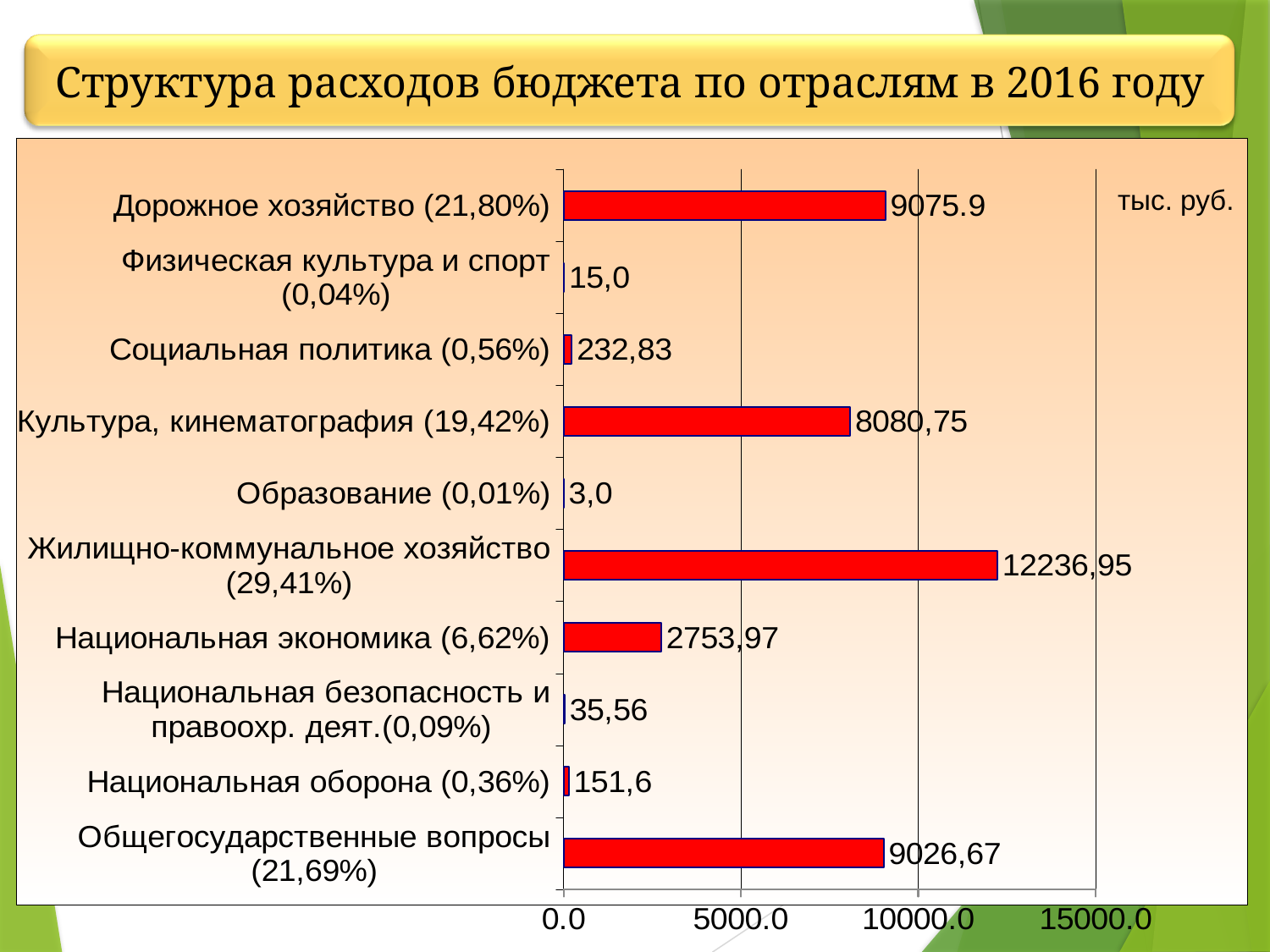
What is the value for Национальная оборона (0,36%)? 151,6 How many categories are shown in the chart? 10 What is the value for Жилищно-коммунальное хозяйство (29,41%)? 12236,95 Which category has the highest value? Жилищно-коммунальное хозяйство (29,41%) What type of chart is shown on the slide? bar chart Which is larger: the value for Дорожное хозяйство or the value for Общегосударственные вопросы? Дорожное хозяйство What is the value for Культура, кинематография (19,42%)? 8080,75 What is the value for Социальная политика (0,56%)? 232,83 Is the value for Национальная экономика (6,62%) greater or less than 5000.0? less What unit is indicated in the top right corner of the chart? тыс. руб. Which category has the lowest value? Образование (0,01%) What is the difference between the values for Жилищно-коммунальное хозяйство and Дорожное хозяйство? 3161,05